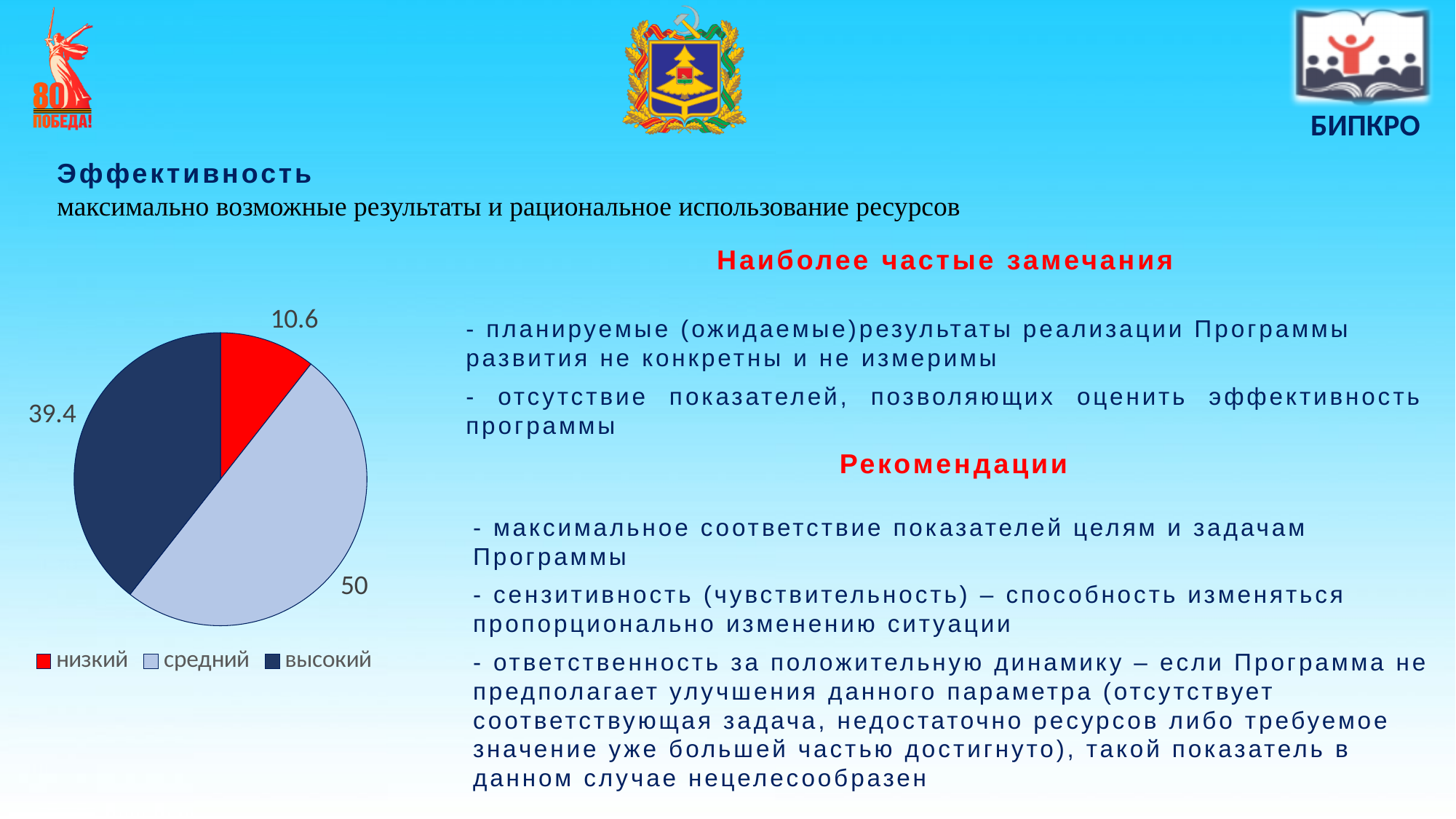
What is the value for the "низкий" slice of the pie chart? 10.6 What is the difference between the "высокий" and "низкий" values in the pie chart? 28.8 How many slices does the pie chart have? 3 What is the value for the "средний" slice of the pie chart? 50 What is the value for the "высокий" slice of the pie chart? 39.4 Which category has the smallest slice in the pie chart? низкий What is the difference between the "средний" and "высокий" values in the pie chart? 10.6 Which category has the largest slice in the pie chart? средний How many entries does the legend of the pie chart list? 3 What colour is the "низкий" slice in the pie chart? red Which is larger in the pie chart, "высокий" or "низкий"? высокий What kind of chart is shown on the slide? pie chart